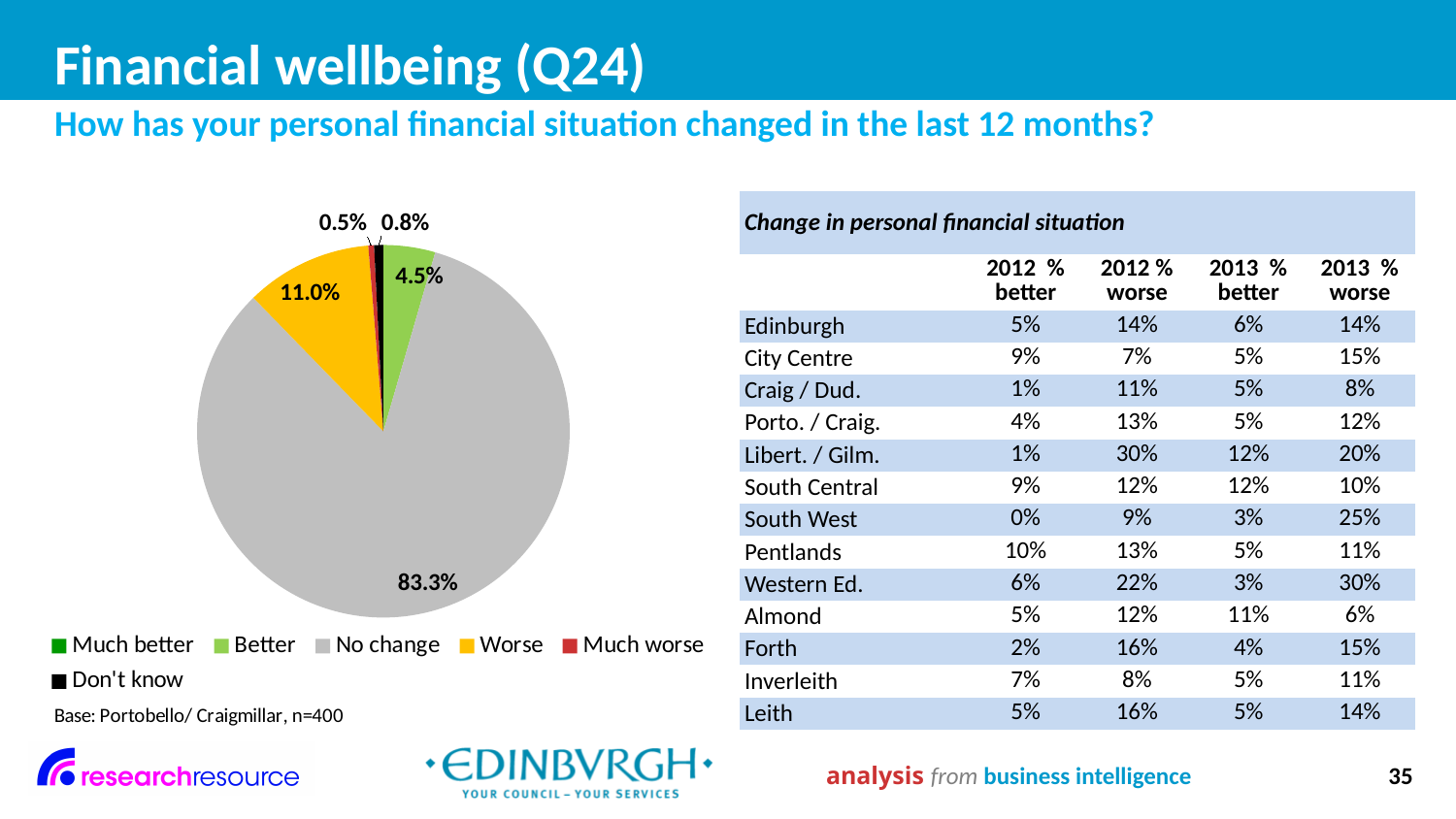
What is the smallest percentage labelled on the pie chart? 0.5% Which category has the largest share of the pie? No change What percentage of respondents said their financial situation was 'Worse'? 11.0% What colour represents 'No change' in the pie chart? grey What percentage of respondents reported 'No change' in their personal financial situation? 83.3% What is the difference between the 'No change' share and the 'Worse' share? 72.3% What kind of chart is shown on the slide? pie chart What is the base (sample size) stated for the pie chart? Portobello/ Craigmillar, n=400 What is the difference between the 'Worse' share and the 'Better' share? 6.5% Which is larger, the share for 'Worse' or the share for 'Better'? Worse How many categories does the legend of the pie chart list? 6 What percentage of respondents said their financial situation was 'Better'? 4.5%